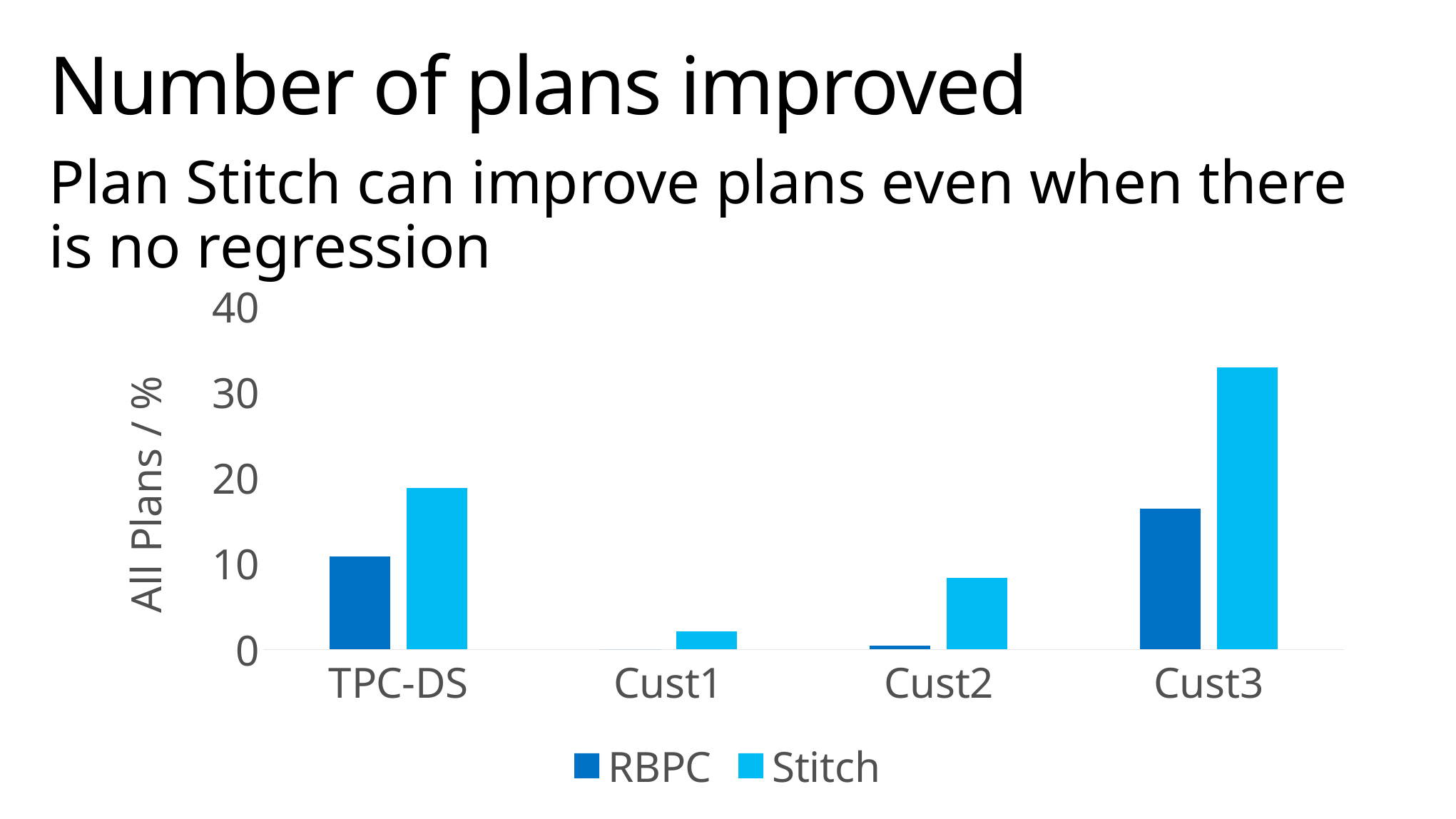
Which category has the highest Stitch value? Cust3 For Cust3, which series has the larger value, RBPC or Stitch? Stitch Is the RBPC value for TPC-DS greater or less than 20? less What kind of chart is shown on the slide? bar chart What is the label of the y axis? All Plans / % How many series does the legend list? 2 Is the Stitch value for Cust3 greater or less than 30? greater Is the Stitch value for Cust2 greater or less than 10? less How many categories are shown on the x axis? 4 Which category has the highest RBPC value? Cust3 What are the two series named in the legend? RBPC and Stitch Which category has the lowest Stitch value? Cust1